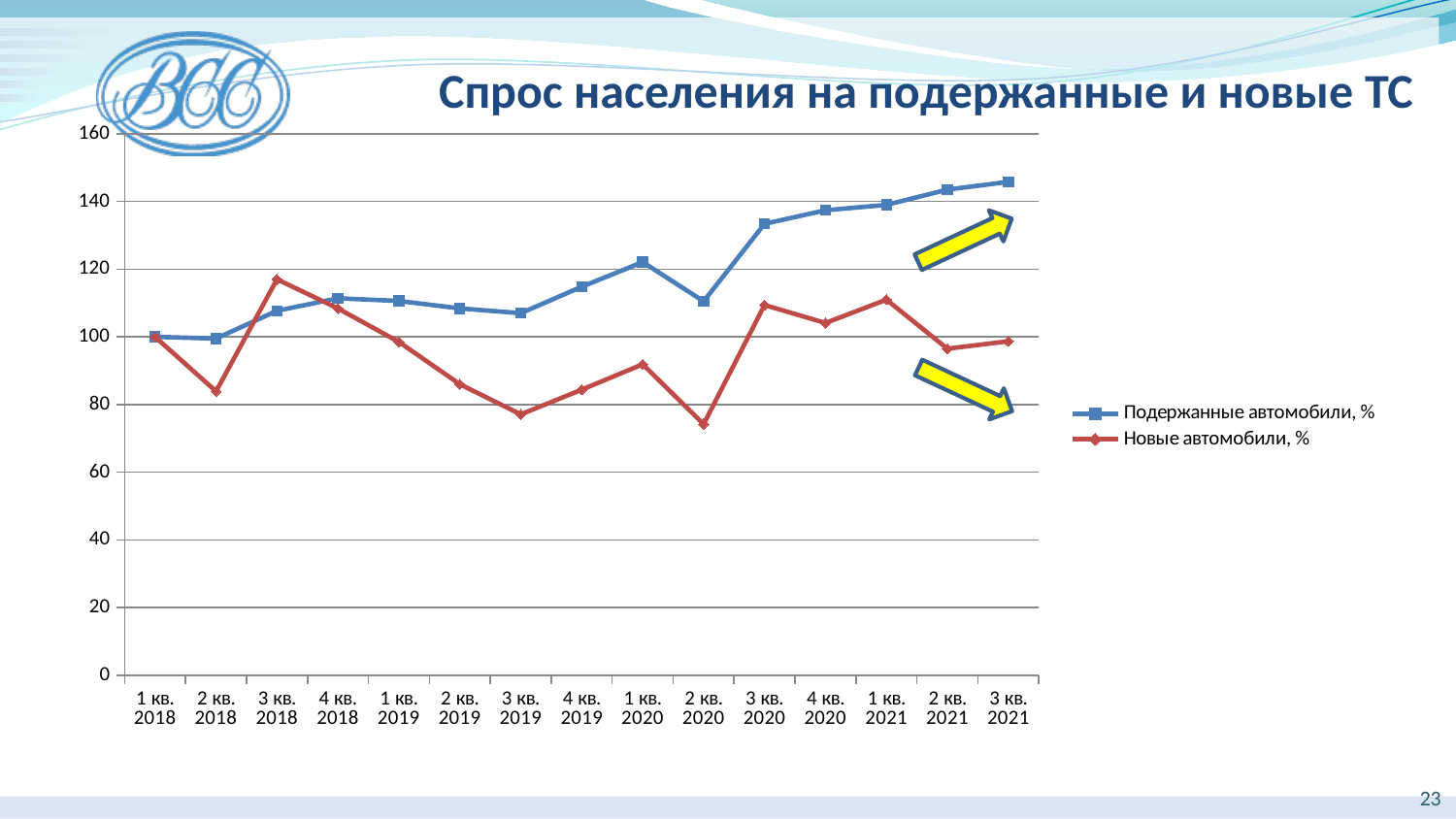
Is the value for Новые автомобили, % in 2 кв. 2020 greater or less than 80? less Is the value for Новые автомобили, % in 3 кв. 2018 greater or less than 100? greater What kind of chart is shown on the slide? Line chart Is the value for Подержанные автомобили, % in 3 кв. 2021 greater or less than 140? greater How many quarters are plotted along the x axis? 15 What is the value for Подержанные автомобили, % in 1 кв. 2018? 100 In which quarter does Подержанные автомобили, % reach its highest value? 3 кв. 2021 What is the title of the chart? Спрос населения на подержанные и новые ТС Does Подержанные автомобили, % rise or fall from 1 кв. 2021 to 3 кв. 2021? rise How many series does the legend list? 2 In 3 кв. 2020, which series has the higher value, Подержанные автомобили, % or Новые автомобили, %? Подержанные автомобили, % In which quarter does Новые автомобили, % reach its highest value? 3 кв. 2018